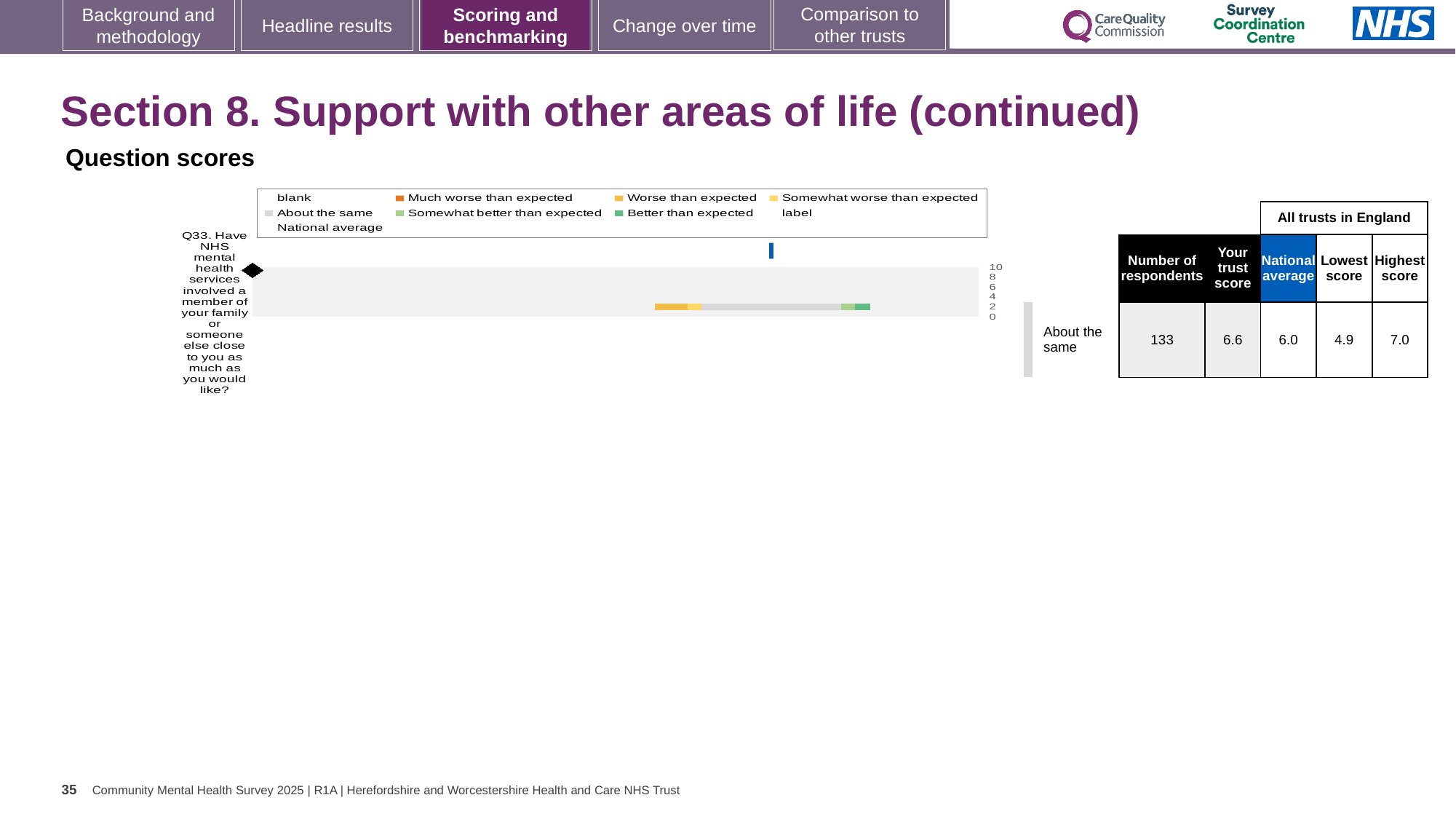
What is the lowest score among all trusts in England for Q33? 4.9 How many respondents answered Q33? 133 How many survey questions are plotted in the chart? 1 How many entries does the chart legend list? 9 What is the national average for Q33 shown in the table? 6.0 What is the difference between the highest and lowest scores for Q33? 2.1 What is the highest score among all trusts in England for Q33? 7.0 Which is larger for Q33, the trust score or the national average? trust score What benchmark category is shown for Q33 next to the chart? About the same What is the trust score for Q33 shown in the table next to the chart? 6.6 Which question number is plotted in the chart? Q33 What kind of chart is shown on the slide? bar chart